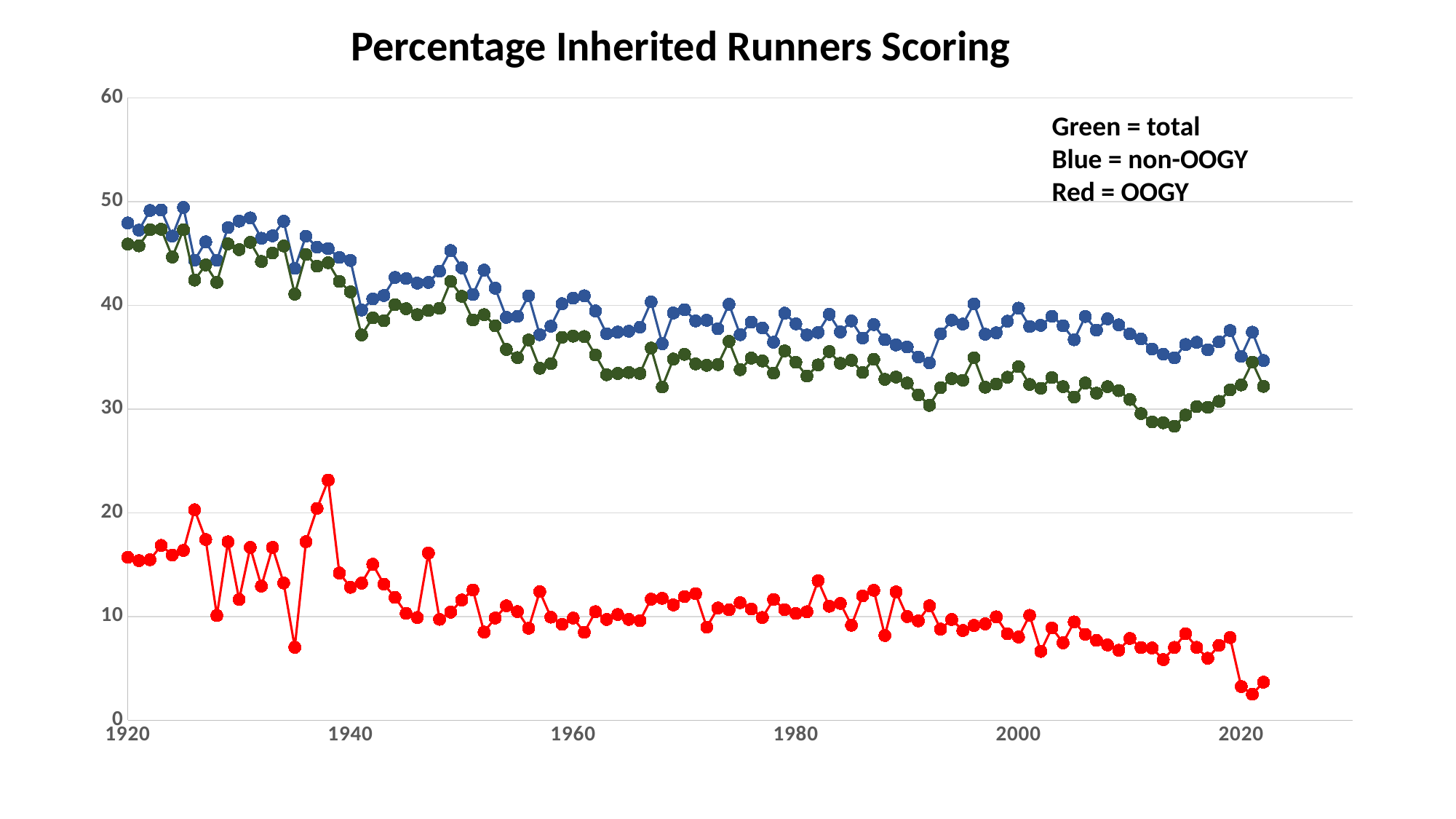
Is the value for the blue (non-OOGY) series in 1920 greater or less than 40? greater Do the values of the red (OOGY) series generally rise or fall from 1920 to 2020? fall Is the value for the red (OOGY) series in 1920 greater or less than 20? less Is the value for the red (OOGY) series in 2020 greater or less than 10? less What kind of chart is shown on the slide? line chart Do the values of the blue (non-OOGY) series generally rise or fall from 1920 to 2020? fall Which colour represents the OOGY series? Red Which series has the lowest values throughout the chart? Red (OOGY) Which series has the larger value in 1920, blue (non-OOGY) or red (OOGY)? blue (non-OOGY) What is the title of the chart? Percentage Inherited Runners Scoring How many series does the legend list? 3